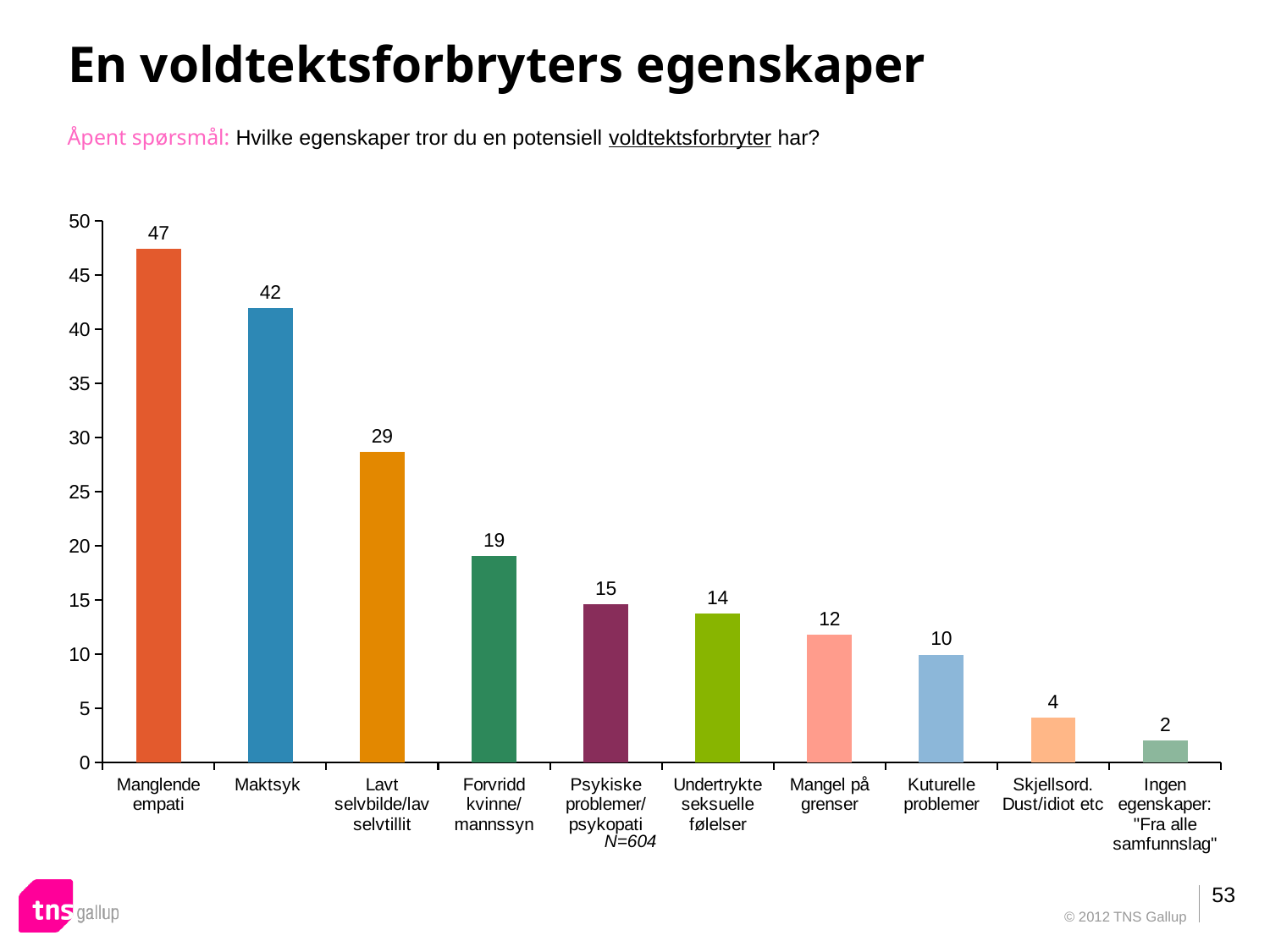
What is the difference between the values for Manglende empati and Maktsyk? 5 What is the value for Kuturelle problemer? 10 What is the value for Maktsyk? 42 Which category has the highest value? Manglende empati Do the values rise or fall from left to right along the x axis? Fall Which category has the lowest value? Ingen egenskaper: "Fra alle samfunnslag" How many categories are shown in the chart? 10 Which is larger, the value for Psykiske problemer/psykopati or the value for Undertrykte seksuelle følelser? Psykiske problemer/psykopati What is the sample size (N) noted on the chart? N=604 What is the value for Manglende empati? 47 What kind of chart is shown on the slide? Bar chart What is the value for Forvridd kvinne/mannssyn? 19